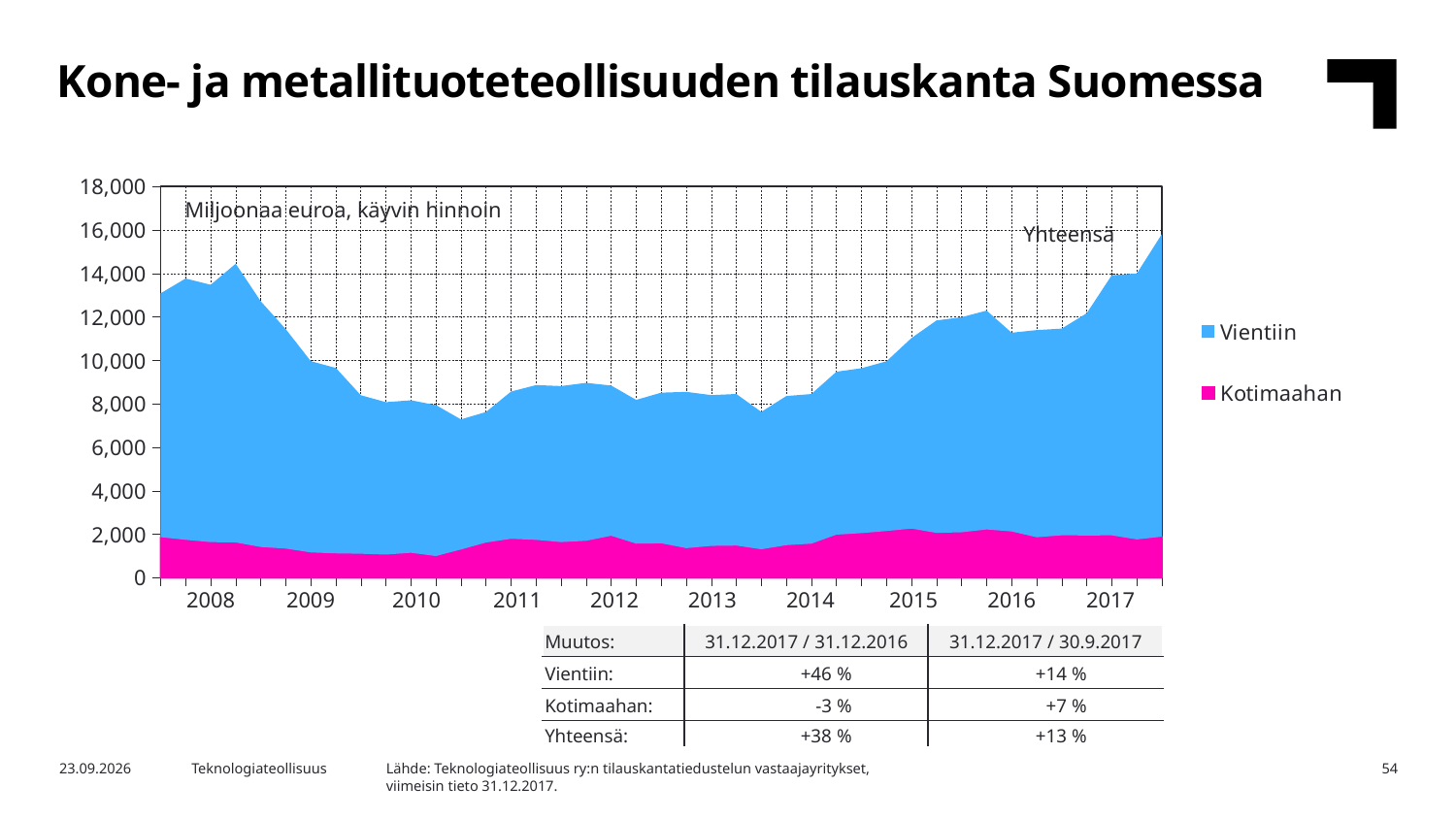
How many series does the legend list? 2 What kind of chart is shown on the slide? Area chart Does the total order backlog rise or fall from 2008 to 2010? fall What unit is stated in the chart for the values? Miljoonaa euroa, käyvin hinnoin Which two series are listed in the chart legend? Vientiin and Kotimaahan Is the Kotimaahan series ever greater or less than 4,000 over the whole period? less Is the total order backlog (Yhteensä) during 2010 greater or less than 10,000? less How many years are labelled on the x axis of the chart? 10 Does the total order backlog rise or fall from 2016 to the end of 2017? rise Is the total order backlog at the start of 2008 greater or less than 12,000? greater Which series is larger throughout the chart, Vientiin or Kotimaahan? Vientiin